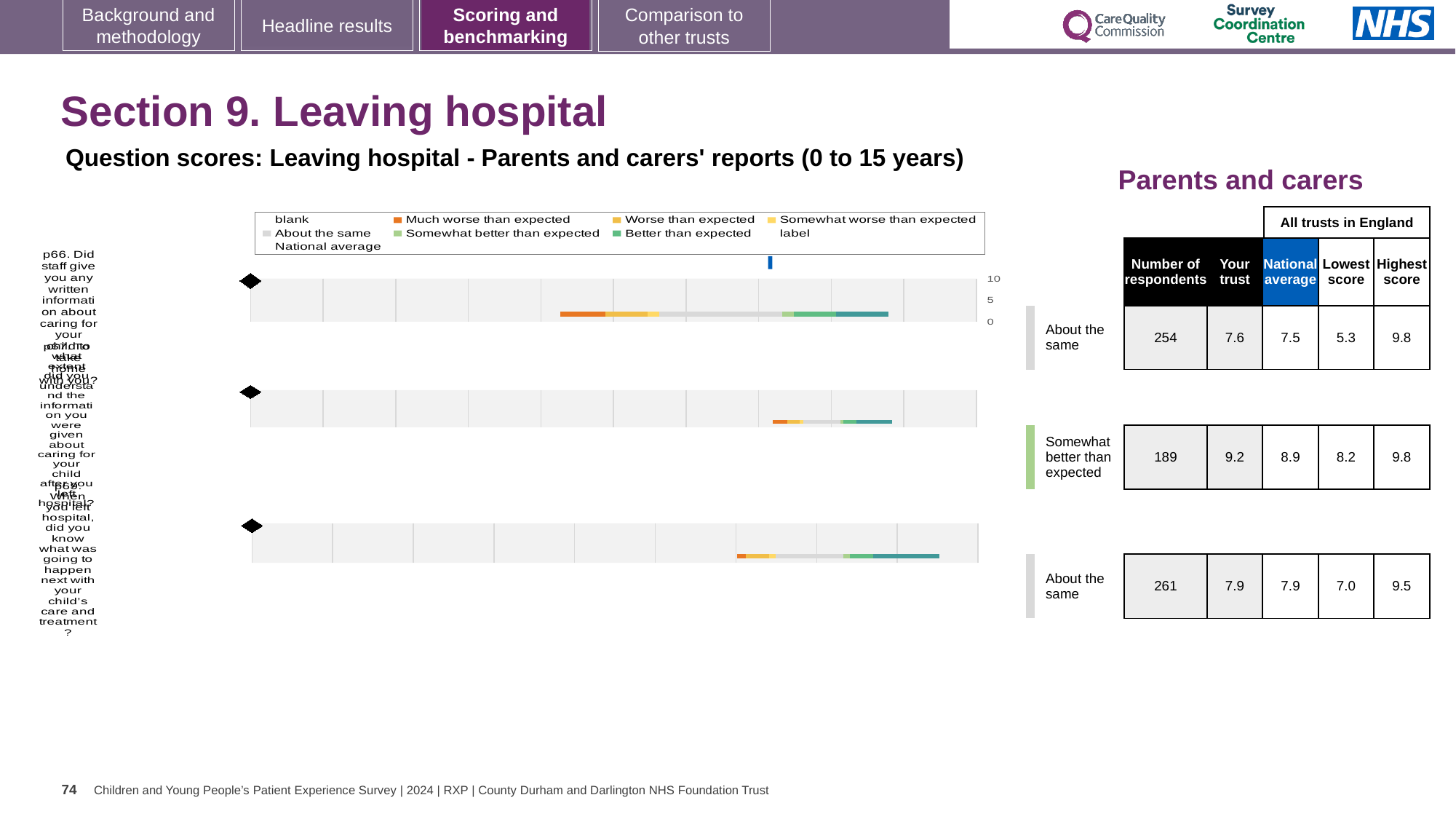
In the table beside the charts, what is the 'Your trust' score for the row labelled 'Somewhat better than expected'? 9.2 In the chart legend, what colour represents 'Much worse than expected'? orange For the row labelled 'Somewhat better than expected', which is larger: the 'Your trust' score or the national average? Your trust Which row in the table has the highest 'Your trust' score? Somewhat better than expected In the table beside the charts, what is the lowest score for the first row (254 respondents)? 5.3 What is the highest tick value shown on the chart axis? 10 What kind of chart is used to show the question scores on this slide? bar chart For the row labelled 'Somewhat better than expected', what is the difference between the 'Your trust' score and the national average? 0.3 In the table beside the charts, what is the highest score for the third row (261 respondents)? 9.5 How many separate question bars are plotted on the slide? 3 In the table beside the charts, what is the number of respondents for the row labelled 'Somewhat better than expected'? 189 Which row in the table has the lowest number of respondents? Somewhat better than expected